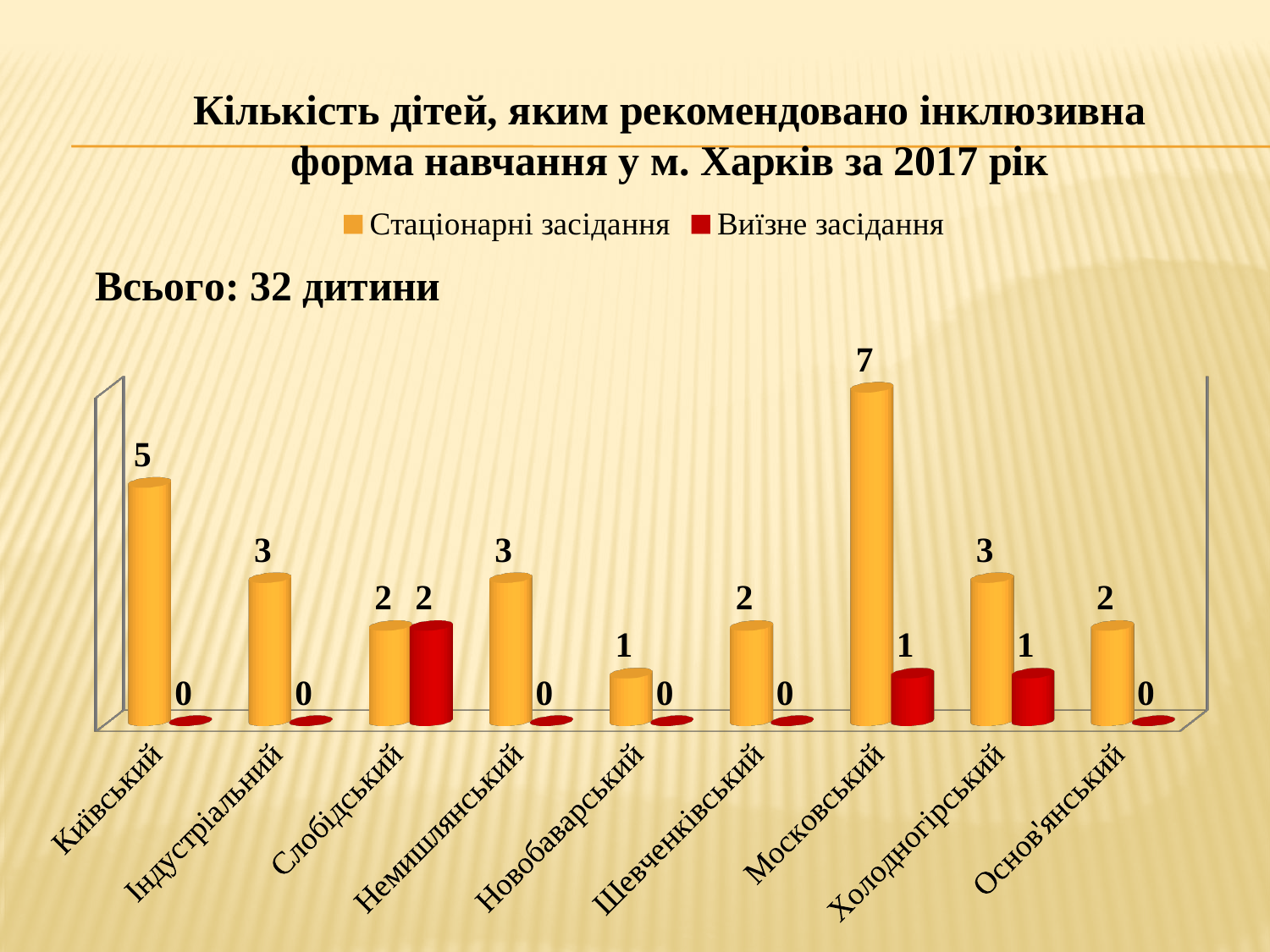
What total number of children is stated on the slide? 32 дитини What kind of chart is shown on the slide? Bar chart Which colour represents Виїзне засідання in the legend? Red What is the value for Стаціонарні засідання in Московський? 7 Which district has the lowest value for Стаціонарні засідання? Новобаварський How many series does the legend list? 2 What is the difference between the Стаціонарні засідання values for Московський and Київський? 2 How many districts are shown on the x axis? 9 Which is larger: the Стаціонарні засідання value for Київський or for Холодногірський? Київський What is the value for Виїзне засідання in Слобідський? 2 Which district has the highest value for Стаціонарні засідання? Московський What is the value for Стаціонарні засідання in Новобаварський? 1